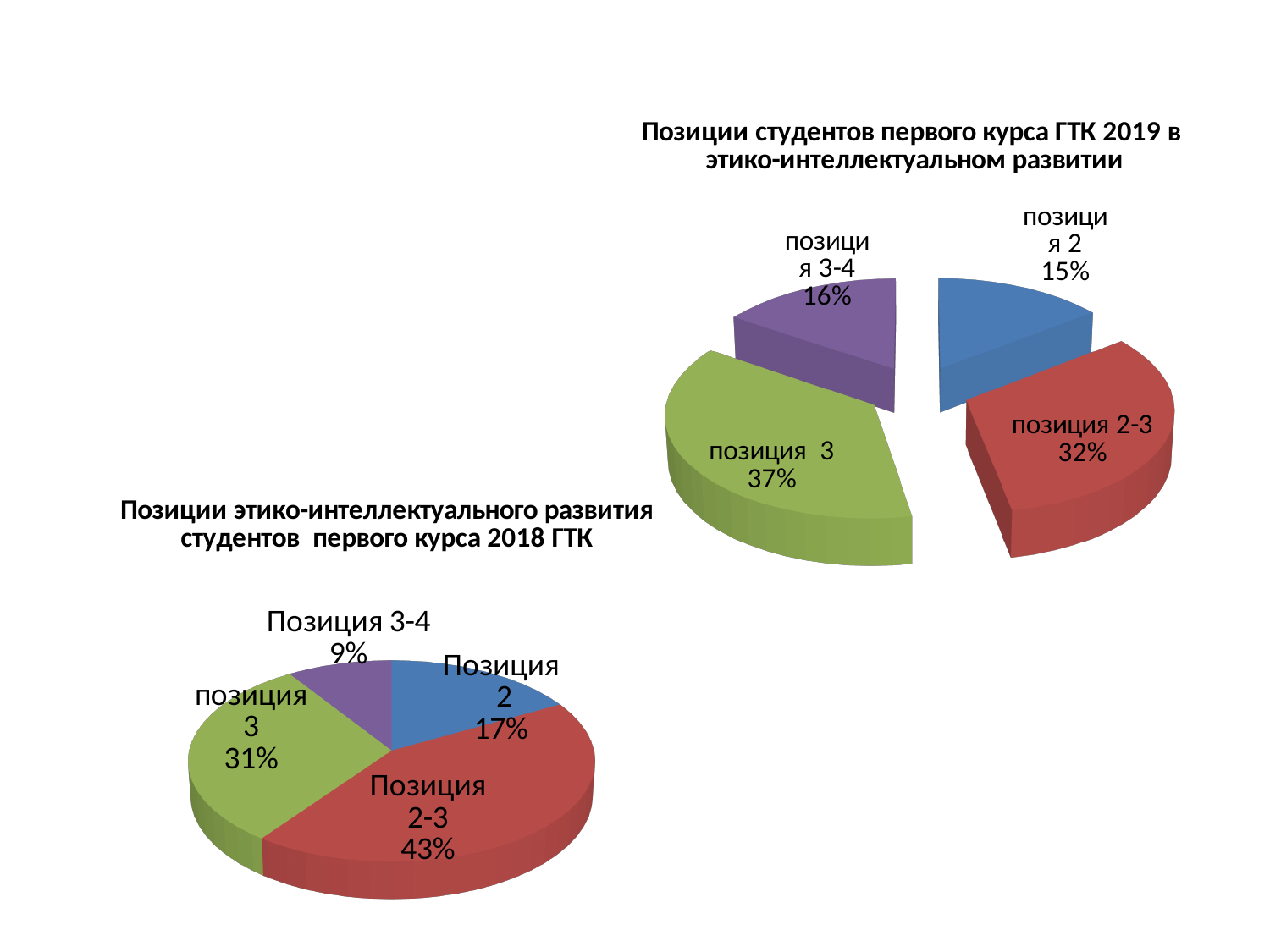
How many slices does the 2019 chart (top right) have? 4 In the 2019 chart (top right), what share does 'позиция 3' have? 37% In the 2019 chart (top right), what is the difference between the shares of 'позиция 2-3' and 'позиция 3-4'? 16% In the 2018 chart (bottom left), what is the difference between 'Позиция 2-3' and 'позиция 3'? 12% In the 2019 chart (top right), what share does 'позиция 2' have? 15% What type of chart is the 2018 chart (bottom left)? Pie chart In the 2019 chart (top right), which category has the largest share? позиция 3 In the 2018 chart (bottom left), which is larger: 'позиция 3' or 'Позиция 2'? позиция 3 In the 2018 chart (bottom left), what share does 'Позиция 3-4' have? 9% In the 2018 chart (bottom left), what share does 'Позиция 2-3' have? 43% What is the title of the chart at the top right of the slide? Позиции студентов первого курса ГТК 2019 в этико-интеллектуальном развитии In the 2018 chart (bottom left), which category has the smallest share? Позиция 3-4